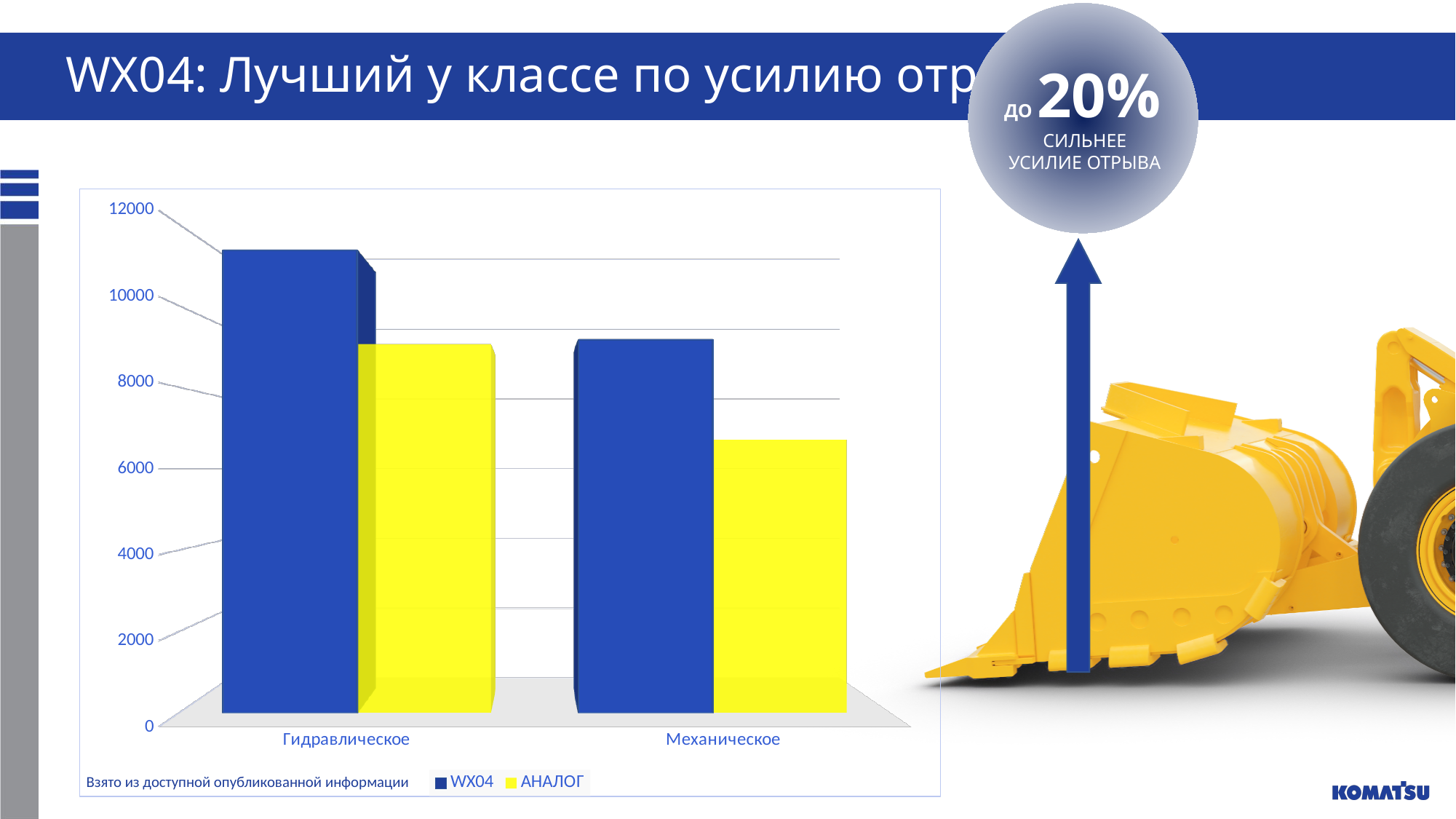
How many series does the chart legend list? 2 Which bar in the chart is the tallest? WX04, Гидравлическое For the Гидравлическое category, which series has the larger value, WX04 or АНАЛОГ? WX04 Is the WX04 value for Гидравлическое greater or less than 10000? greater For the Механическое category, which series has the larger value, WX04 or АНАЛОГ? WX04 Is the WX04 value for Механическое greater or less than 8000? greater What colour are the WX04 bars in the chart? blue Is the АНАЛОГ value for Гидравлическое greater or less than 10000? less What kind of chart is shown on the slide? bar chart Which series are listed in the chart legend? WX04 and АНАЛОГ How many categories are shown on the x axis of the chart? 2